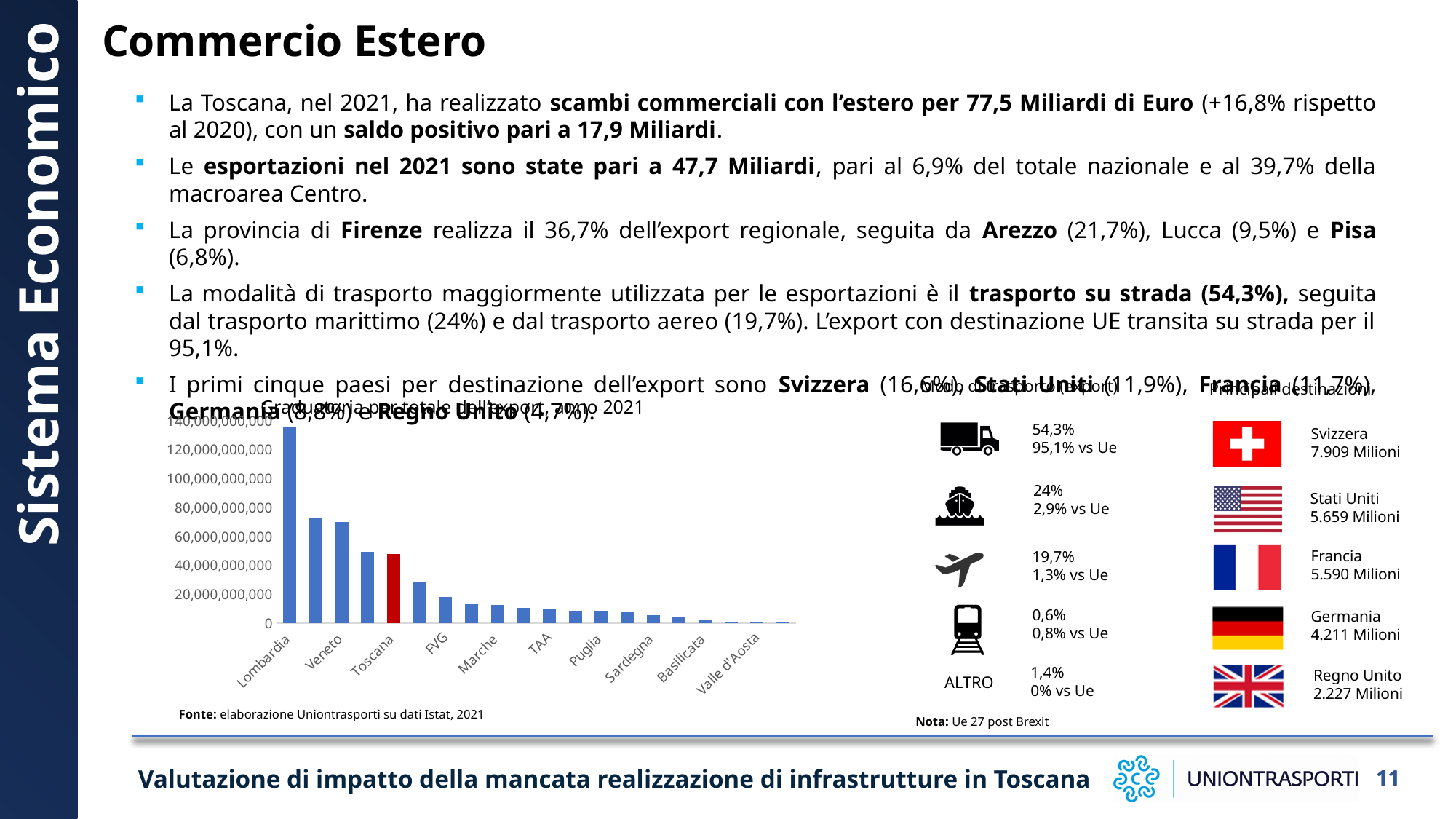
Which region has the highest export total in the bar chart? Lombardia Do the bar values rise or fall moving from left to right along the x axis? fall Which region's bar is highlighted in red in the bar chart? Toscana What is the highest tick value shown on the y axis of the bar chart? 140,000,000,000 What kind of chart is shown on the slide? bar chart Which has a larger export total, Toscana or Marche? Toscana Is the value for Toscana greater or less than 60,000,000,000? less Is the value for Marche greater or less than 20,000,000,000? less Is the value for Veneto greater or less than 60,000,000,000? greater Which has a larger export total, Lombardia or Veneto? Lombardia